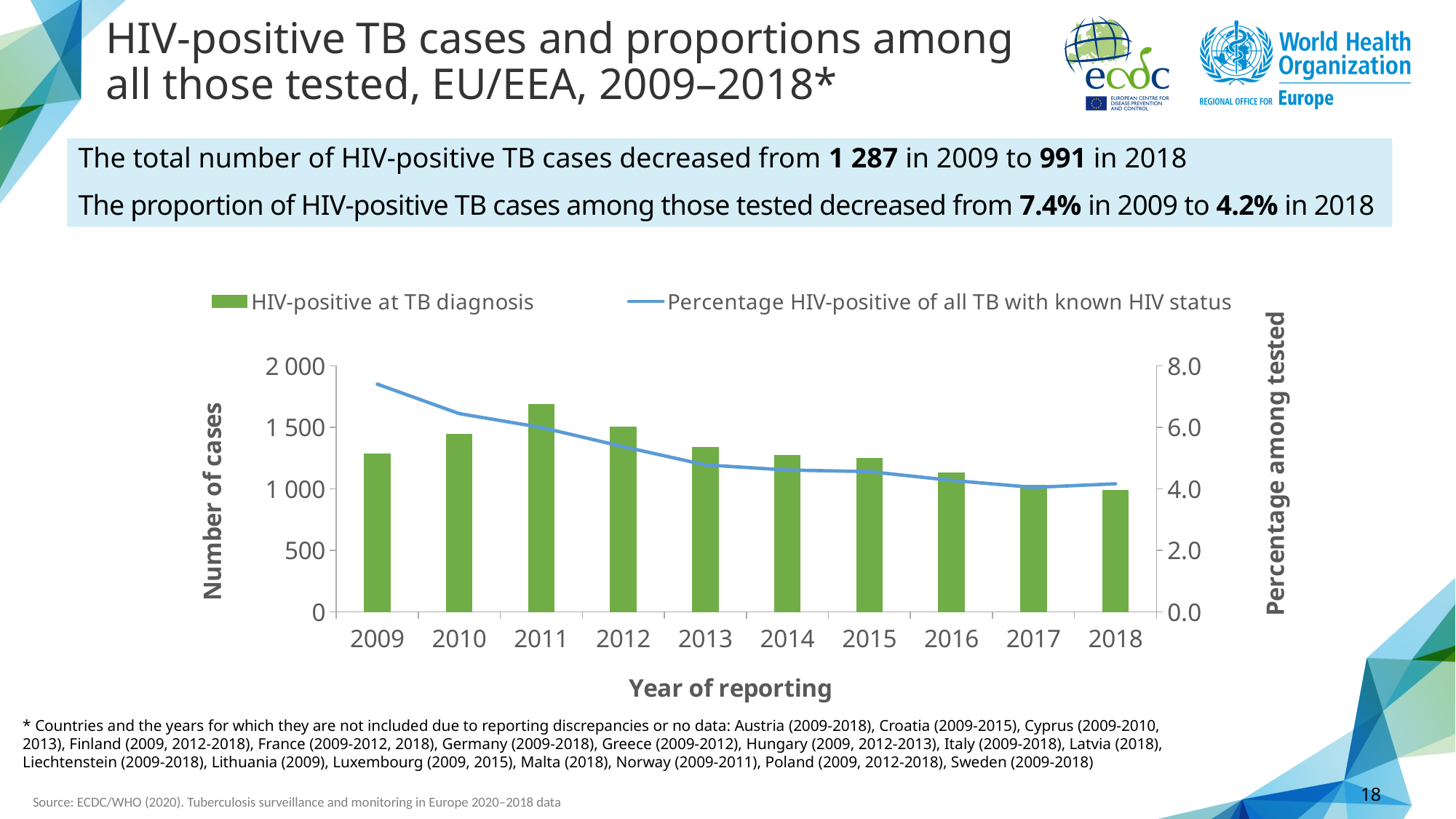
What was the percentage of HIV-positive cases among all TB with known HIV status in 2018? 4.2% Is the number of HIV-positive TB cases in 2013 greater or less than 1 500? less Which year has more HIV-positive TB cases, 2011 or 2012? 2011 How many series does the legend list? 2 Is the number of HIV-positive TB cases in 2016 greater or less than 1 000? greater How many years of reporting are shown on the x axis? 10 Does the percentage of HIV-positive among all TB with known HIV status rise or fall from 2009 to 2018? fall What was the percentage of HIV-positive cases among all TB with known HIV status in 2009? 7.4% What was the number of HIV-positive TB cases in 2009? 1 287 By how much did the number of HIV-positive TB cases decrease from 2009 to 2018? 296 Which year has the highest number of HIV-positive at TB diagnosis? 2011 What was the number of HIV-positive TB cases in 2018? 991